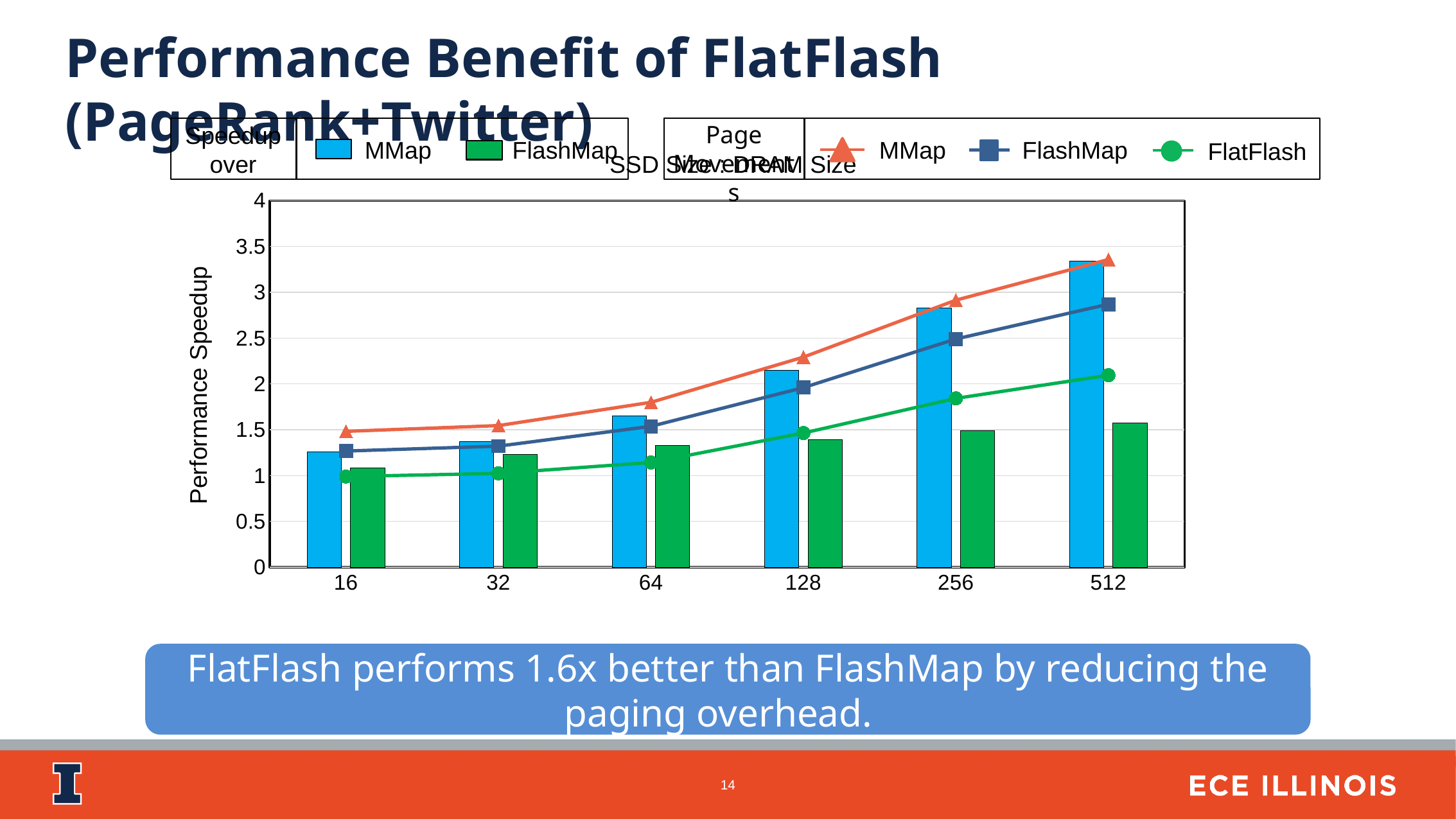
Is the FlatFlash line value at 256 greater or less than 1.5? greater At which x-axis category is the FlashMap bar lowest? 16 What kind of chart is shown on the slide? bar and line chart Is the MMap bar at 256 greater or less than 2.5? greater Is the FlashMap bar at 128 greater or less than 1.5? less Do the MMap line values rise or fall as the SSD size : DRAM size increases from 16 to 512? rise How many series does the line legend (Page Movements) list? 3 At 512, which bar is taller: MMap or FlashMap? MMap How many series does the bar legend (Speedup over) list? 2 How many SSD size : DRAM size categories are shown on the x axis? 6 At which x-axis category is the MMap bar highest? 512